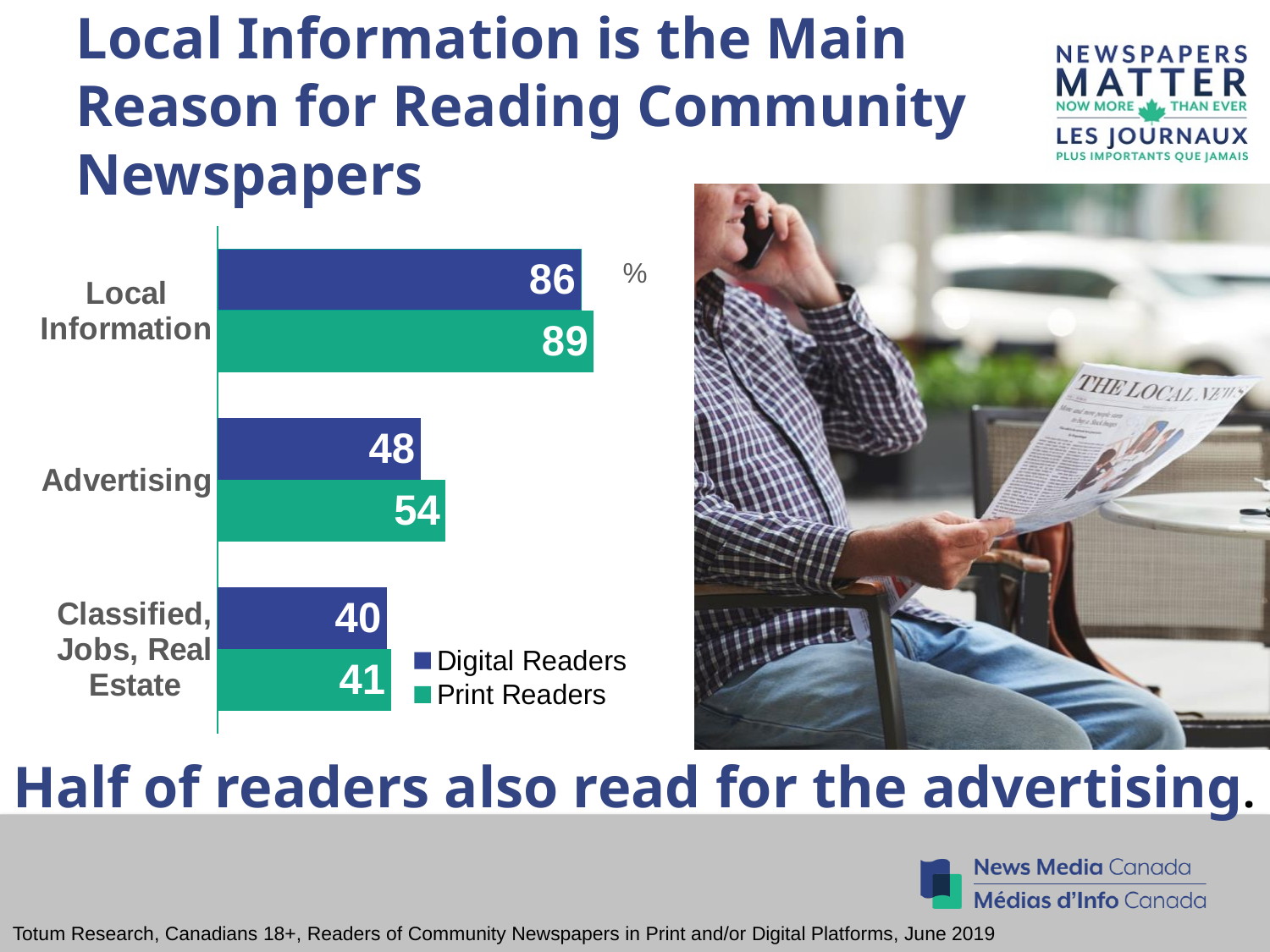
What is the value for Digital Readers for Local Information? 86 What kind of chart is shown on the slide? Bar chart What is the difference between Print Readers and Digital Readers for Advertising? 6 How many categories are shown in the chart? 3 Which category has the lowest value for Digital Readers? Classified, Jobs, Real Estate What is the value for Print Readers for Classified, Jobs, Real Estate? 41 Which series is shown in green in the chart? Print Readers What is the value for Print Readers for Advertising? 54 What is the difference between Print Readers and Digital Readers for Local Information? 3 How many series does the legend list? 2 Which category has the highest value for Print Readers? Local Information Which is larger for Advertising: Digital Readers or Print Readers? Print Readers